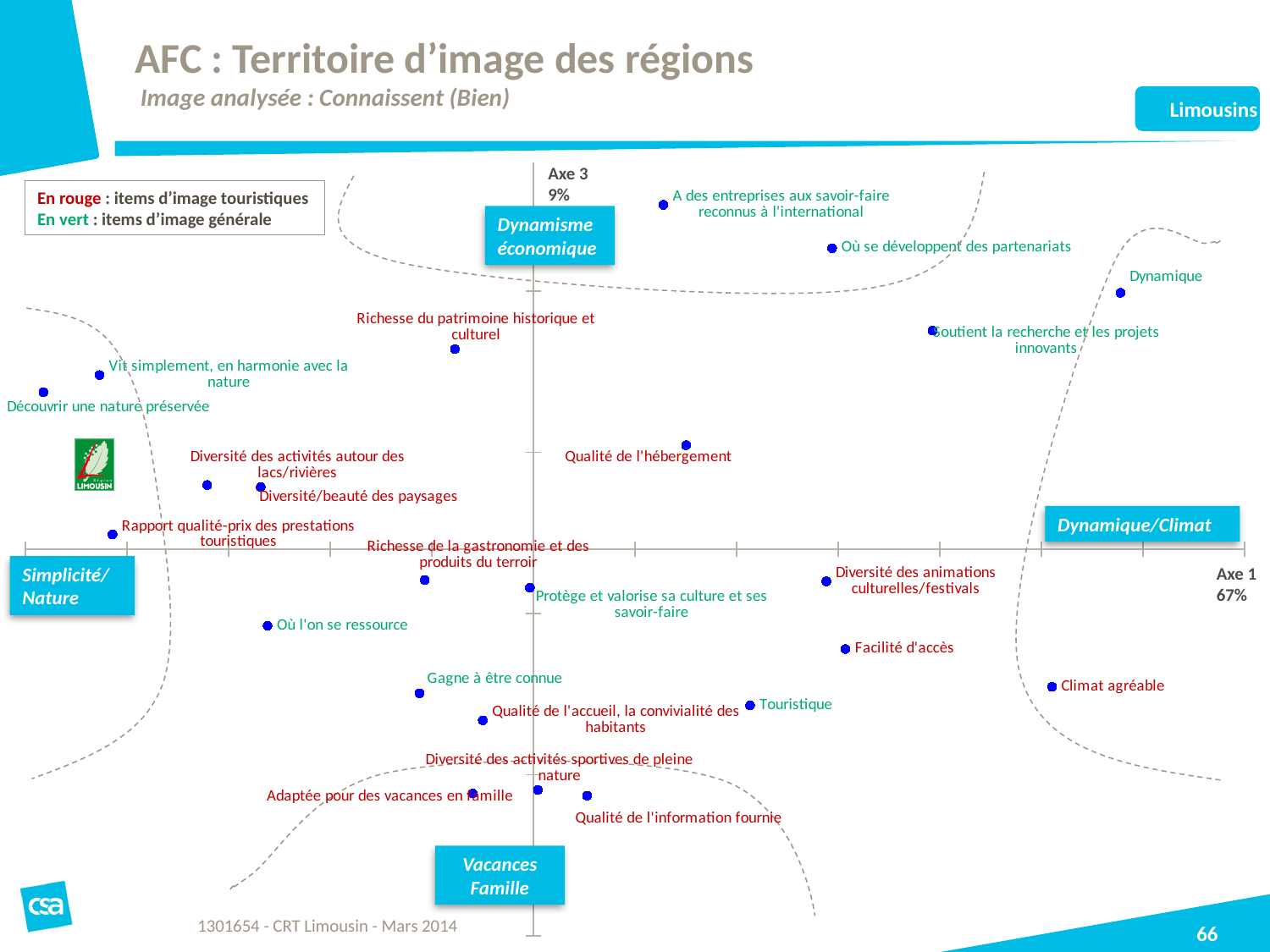
According to the legend, what do the red labels on the chart represent? items d'image touristiques What percentage is shown for Axe 3 on the chart? 9% How many labelled points are plotted on the chart? 23 Which is plotted further to the right: 'Climat agréable' or 'Facilité d'accès'? Climat agréable Which group of respondents does the chart concern, as shown in the box at the top right? Limousins Which item is plotted highest on Axe 3? A des entreprises aux savoir-faire reconnus à l'international Which is plotted higher on Axe 3: 'Dynamique' or 'Climat agréable'? Dynamique Which item is plotted furthest to the right on Axe 1? Dynamique What kind of chart is shown on the slide? scatter plot What percentage is shown for Axe 1 on the chart? 67% Which is plotted higher on Axe 3: 'Richesse du patrimoine historique et culturel' or 'Qualité de l'hébergement'? Richesse du patrimoine historique et culturel Which item is plotted furthest to the left on Axe 1? Découvrir une nature préservée